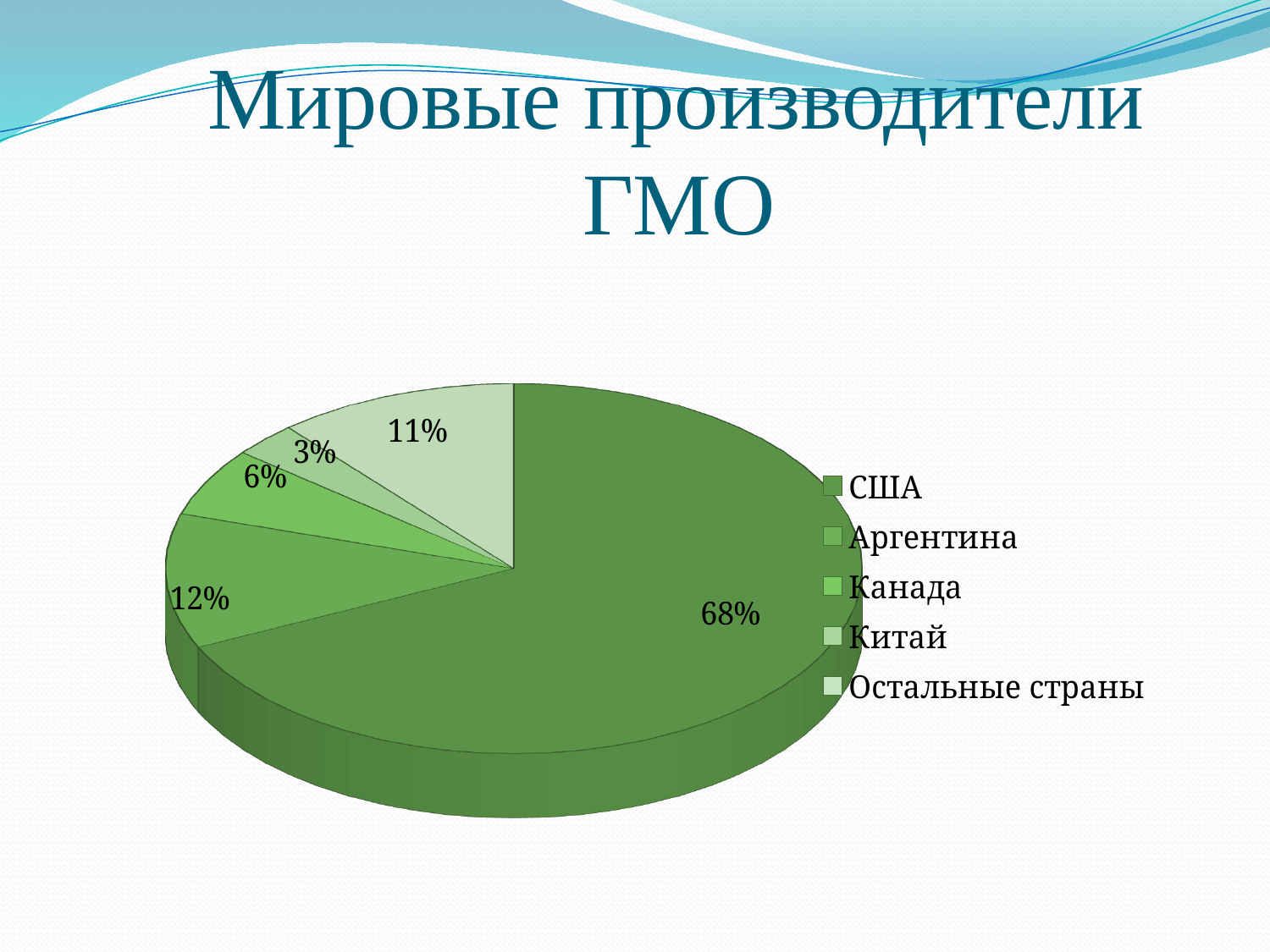
What share of the pie does Остальные страны have? 11% What kind of chart is shown on the slide? pie chart Which has a larger share, Аргентина or Остальные страны? Аргентина What is the title of the chart on the slide? Мировые производители ГМО What share of the pie does Канада have? 6% How many categories does the legend of the pie chart list? 5 What share of the pie does Аргентина have? 12% What is the difference between the shares of США and Аргентина? 56% Which category has the smallest slice of the pie? Китай Which category has the largest slice of the pie? США